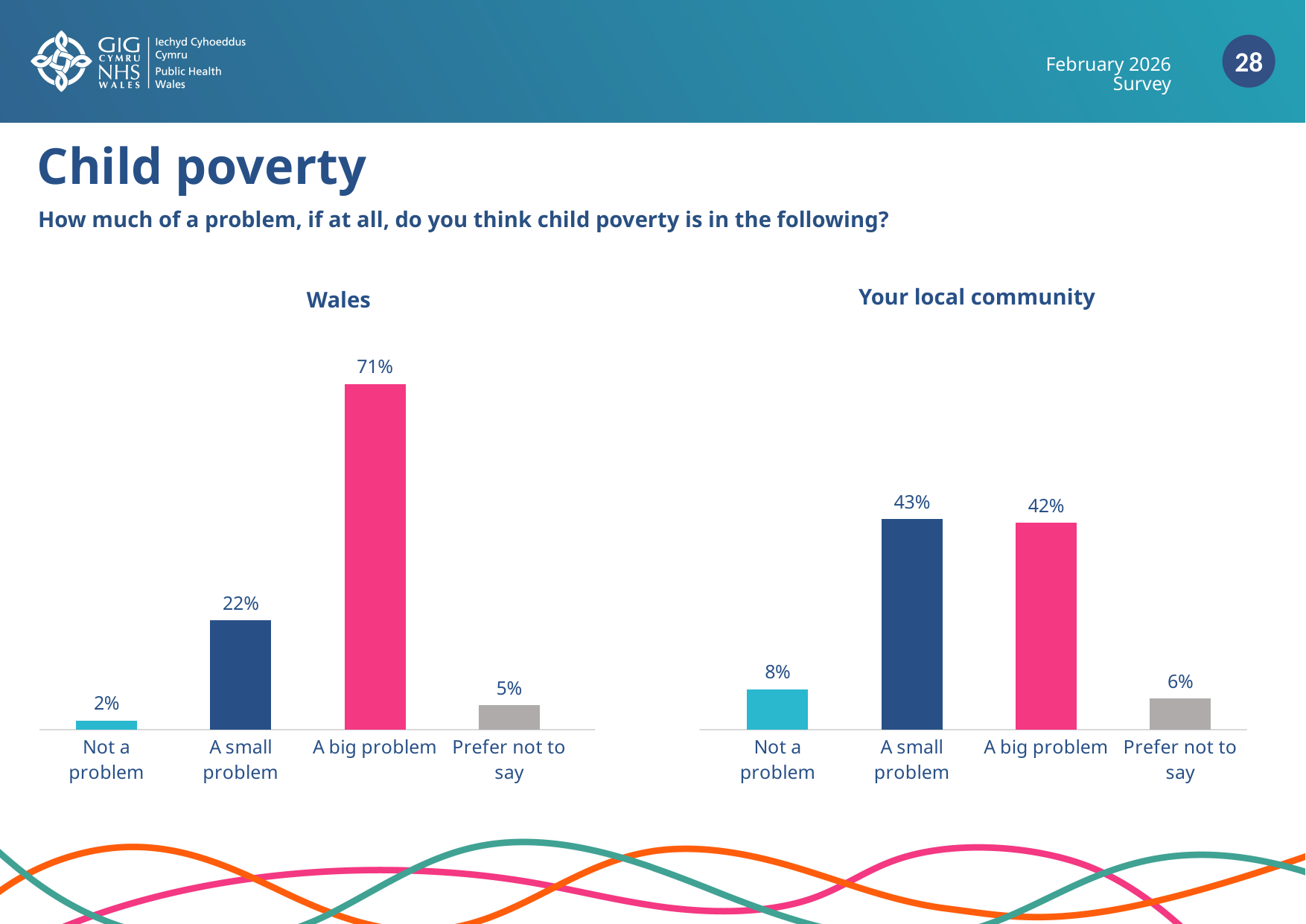
What type of chart is the Wales chart? Bar chart In the Your local community chart, what is the difference between the values for Not a problem and Prefer not to say? 2% In the Wales chart, which category has the lowest value? Not a problem In the Wales chart, what is the difference between the values for A big problem and A small problem? 49% How many categories are shown in the Your local community chart? 4 In the Your local community chart, what is the value for Not a problem? 8% In the Your local community chart, what percentage of respondents said child poverty is a small problem? 43% In the Your local community chart, which category has the lowest value? Prefer not to say What is the title of the chart on the right side of the slide? Your local community In the Wales chart, which category has the highest value? A big problem Which is larger: the value for A big problem in the Wales chart or the value for A big problem in the Your local community chart? Wales In the Wales chart, what percentage of respondents said child poverty is a big problem? 71%